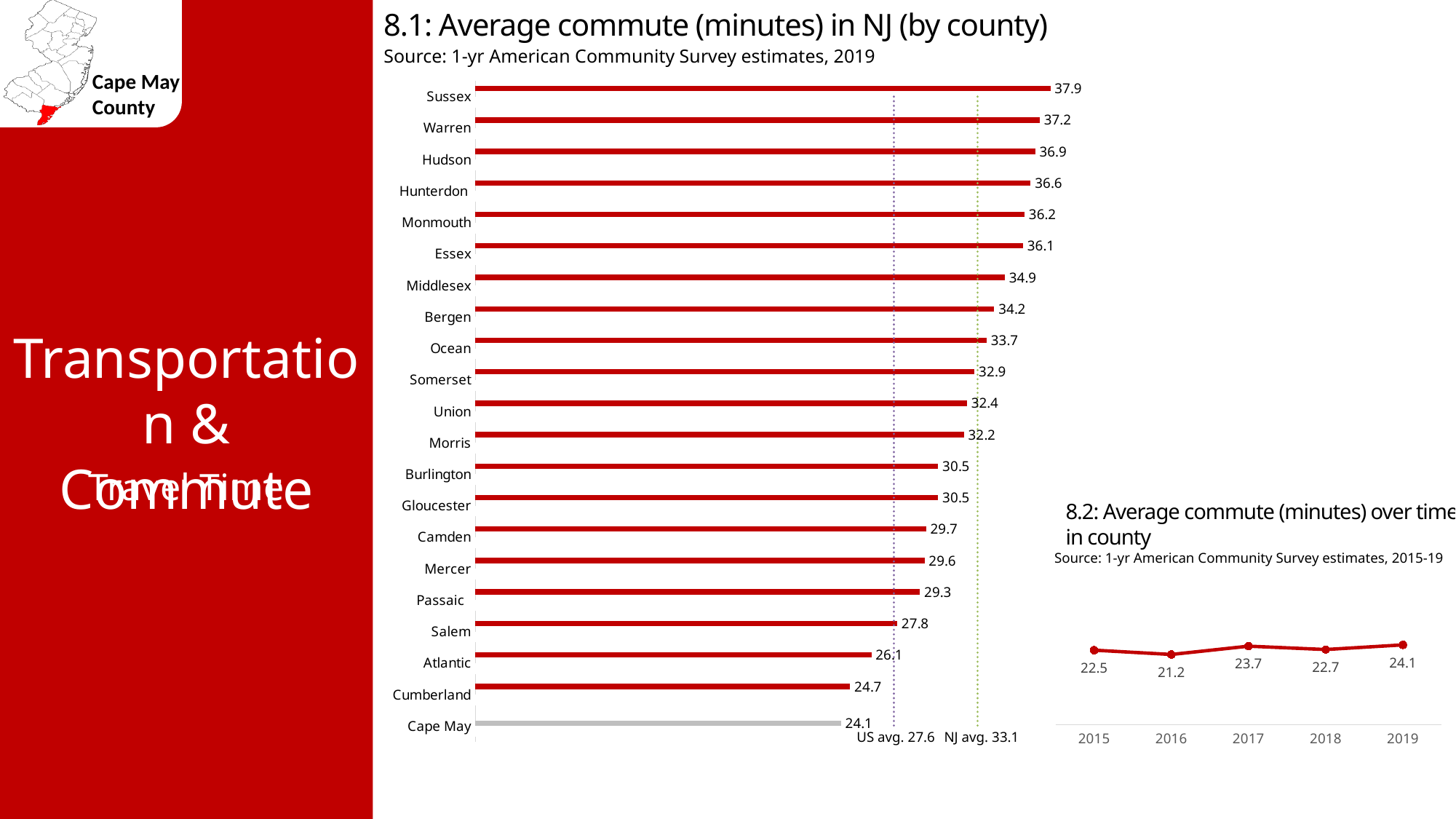
In chart 8.2, which year has the highest average commute? 2019 In chart 8.1, what is the NJ average commute shown by the dotted reference line? 33.1 In chart 8.1, how many counties are shown? 21 In chart 8.1, what is the average commute in minutes for Sussex? 37.9 In chart 8.1, which county has the lowest average commute? Cape May In chart 8.1, which county has the highest average commute? Sussex In chart 8.2, how many years are plotted? 5 In chart 8.1, which county has a longer average commute, Hudson or Ocean? Hudson In chart 8.1, what is the average commute in minutes for Cape May? 24.1 In chart 8.1, what is the difference between the average commute for Sussex and Cape May? 13.8 What kind of chart is chart 8.1? bar chart In chart 8.2, what was the average commute in minutes in 2016? 21.2